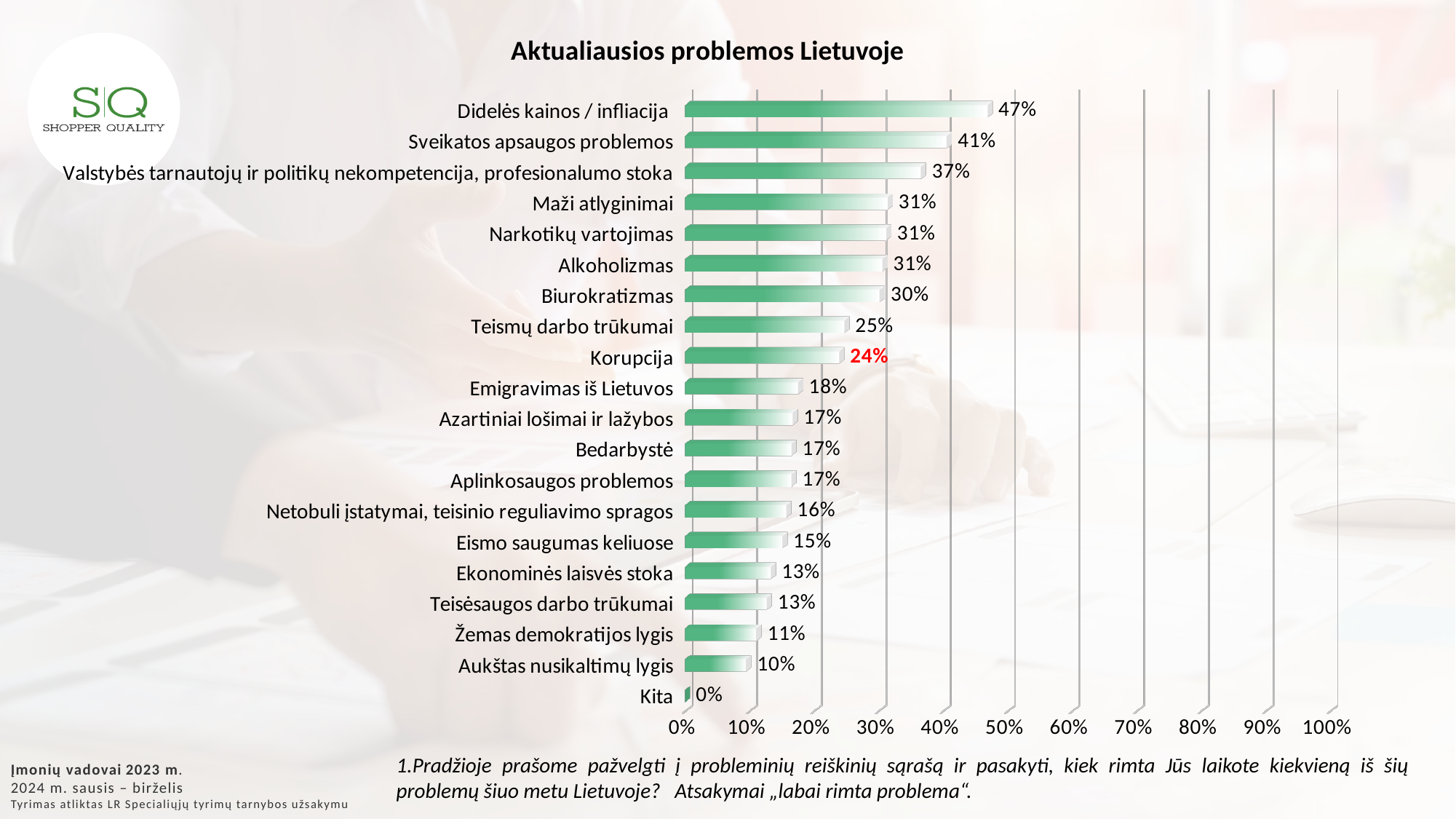
Which is larger, the value for Biurokratizmas or the value for Teismų darbo trūkumai? Biurokratizmas Which category has the highest value? Didelės kainos / infliacija What is the difference between the values for Didelės kainos / infliacija and Sveikatos apsaugos problemos? 6% What kind of chart is shown on the slide? Bar chart Which category's data label is printed in red? Korupcija What is the value for Sveikatos apsaugos problemos? 41% How many categories are shown in the chart? 20 Is the value for Valstybės tarnautojų ir politikų nekompetencija, profesionalumo stoka greater or less than 30%? greater What is the title of the chart? Aktualiausios problemos Lietuvoje What is the value for Korupcija? 24% What is the value for Emigravimas iš Lietuvos? 18% Which category has the lowest value? Kita